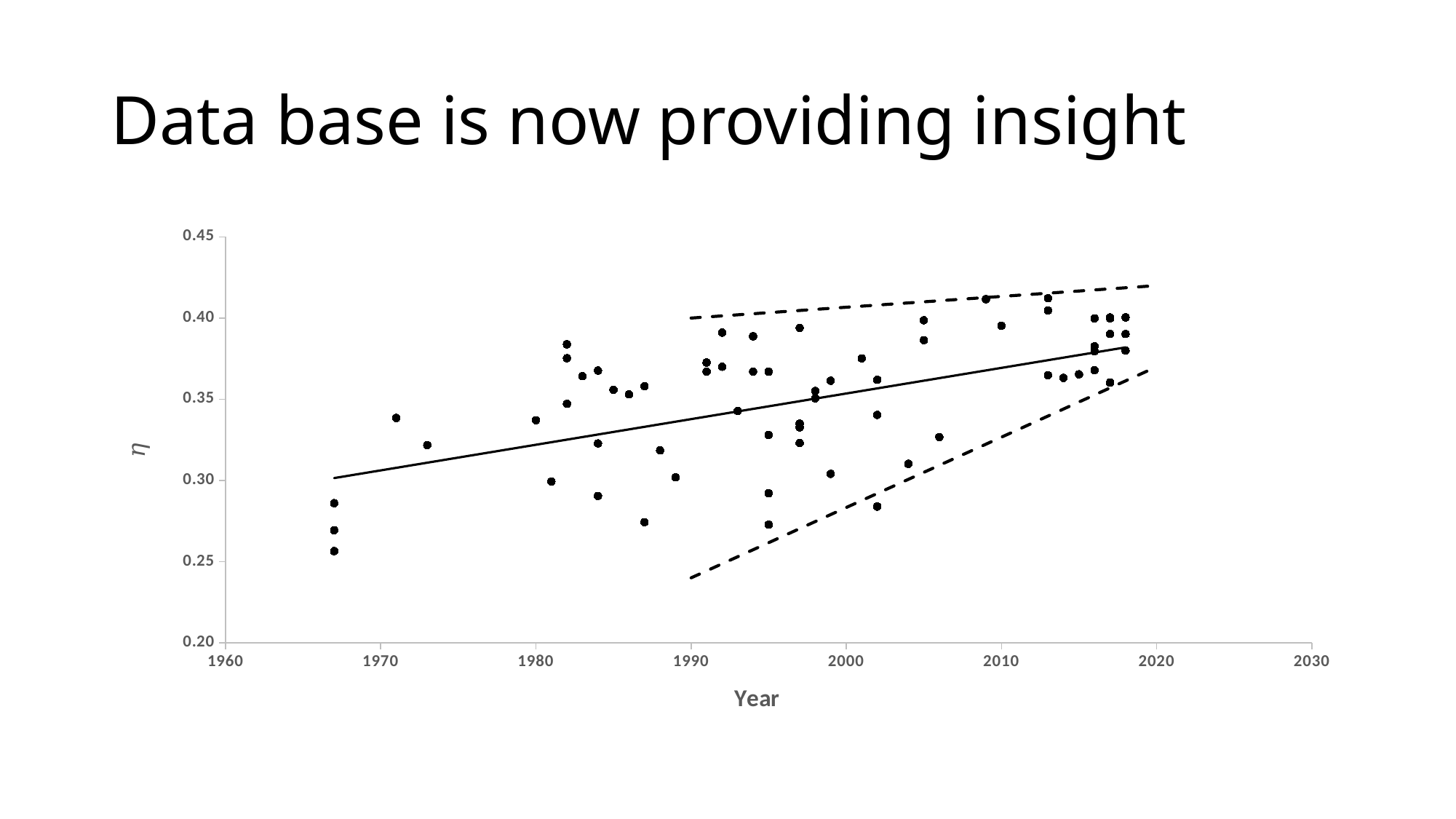
Is the data point plotted at 1973 greater or less than 0.35? less Is the lowest data point plotted at 1967 greater or less than 0.30? less Is the data point plotted at 1988 greater or less than 0.35? less Which is higher, the data point at 1980 or the data point at 1981? 1980 What kind of chart is shown on the slide? scatter chart Does the solid trend line rise or fall as the year increases? rises What is the highest value shown on the y axis of the chart? 0.45 What is the label on the x axis of the chart? Year